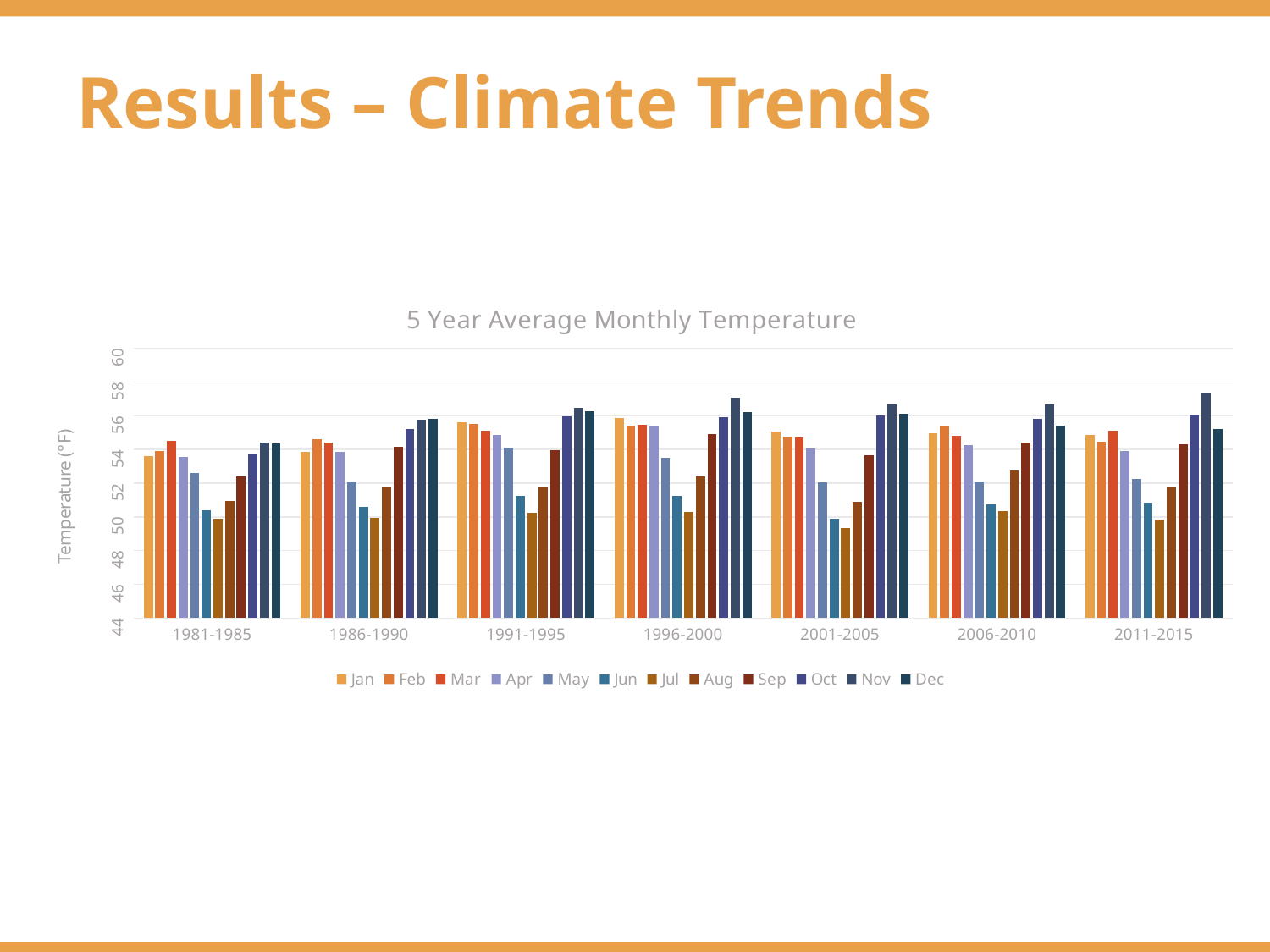
What is the title of the chart? 5 Year Average Monthly Temperature Which month has the highest value in the 1996-2000 period? Nov In the 2011-2015 period, which is larger, the value for Nov or the value for Jul? Nov Is the value for Jan in 1991-1995 greater or less than 54? greater Is the value for Jun in 1981-1985 greater or less than 52? less What is the label on the vertical axis of the chart? Temperature (°F) Which month has the lowest value in the 1996-2000 period? Jul What kind of chart is shown on the slide? Bar chart How many five-year periods are shown along the x axis? 7 How many series does the legend list? 12 Is the value for Nov in 1996-2000 greater or less than 56? greater